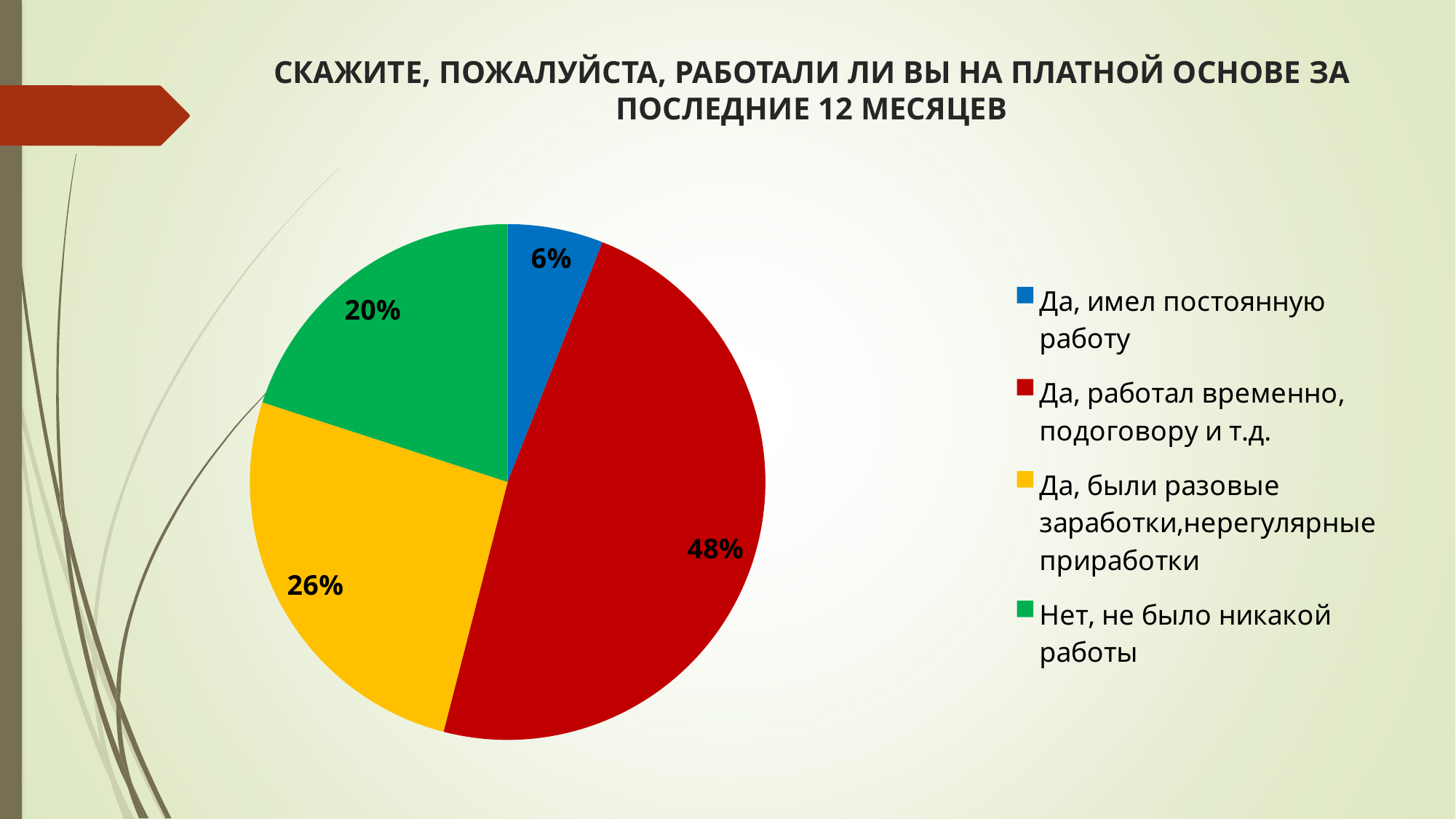
What is the difference in percentage points between "Да, работал временно, подоговору и т.д." and "Нет, не было никакой работы"? 28 What share of respondents answered "Да, имел постоянную работу"? 6% What share of respondents answered "Да, работал временно, подоговору и т.д."? 48% What share of respondents answered "Нет, не было никакой работы"? 20% Which answer option has the largest share of the pie? Да, работал временно, подоговору и т.д. Which answer option has the smallest share of the pie? Да, имел постоянную работу What colour is the slice for "Нет, не было никакой работы"? Green What is the combined share of the three "Да" answer options? 80% Which is larger: the share for "Да, были разовые заработки,нерегулярные приработки" or the share for "Нет, не было никакой работы"? Да, были разовые заработки,нерегулярные приработки What share of respondents answered "Да, были разовые заработки,нерегулярные приработки"? 26% What kind of chart is shown on the slide? Pie chart How many slices does the pie chart have? 4